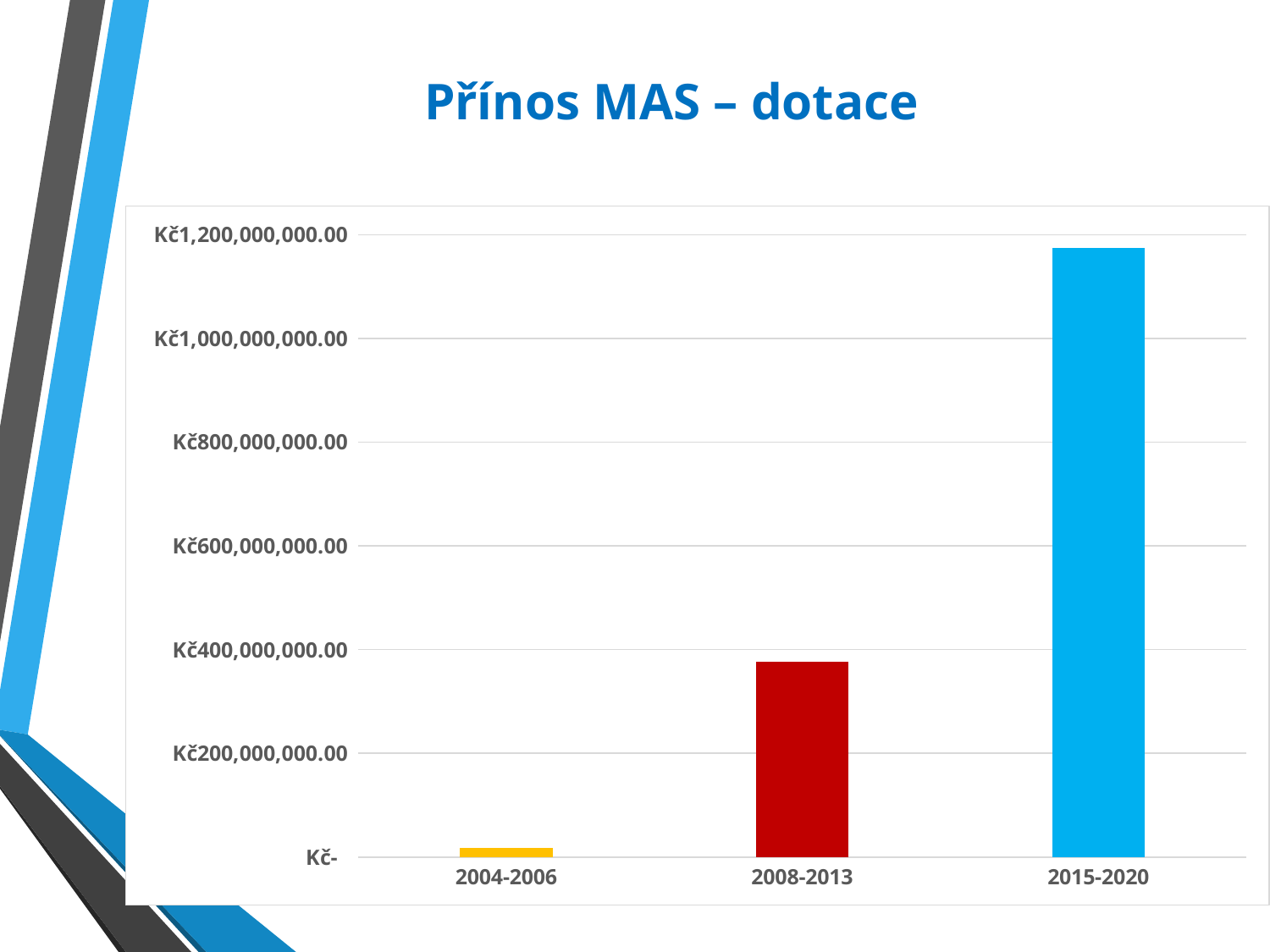
Which period has the lowest value? 2004-2006 Is the value for 2008-2013 greater or less than Kč400,000,000.00? less Which is larger, the value for 2008-2013 or the value for 2015-2020? 2015-2020 What kind of chart is shown on the slide? bar chart What colour is the bar for 2008-2013? red Which is larger, the value for 2004-2006 or the value for 2008-2013? 2008-2013 What is the title of the slide? Přínos MAS – dotace Is the value for 2015-2020 greater or less than Kč1,000,000,000.00? greater How many categories (periods) are shown on the x axis? 3 Which period has the highest value? 2015-2020 Is the value for 2004-2006 greater or less than Kč200,000,000.00? less Do the values rise or fall from 2004-2006 to 2015-2020 along the x axis? rise